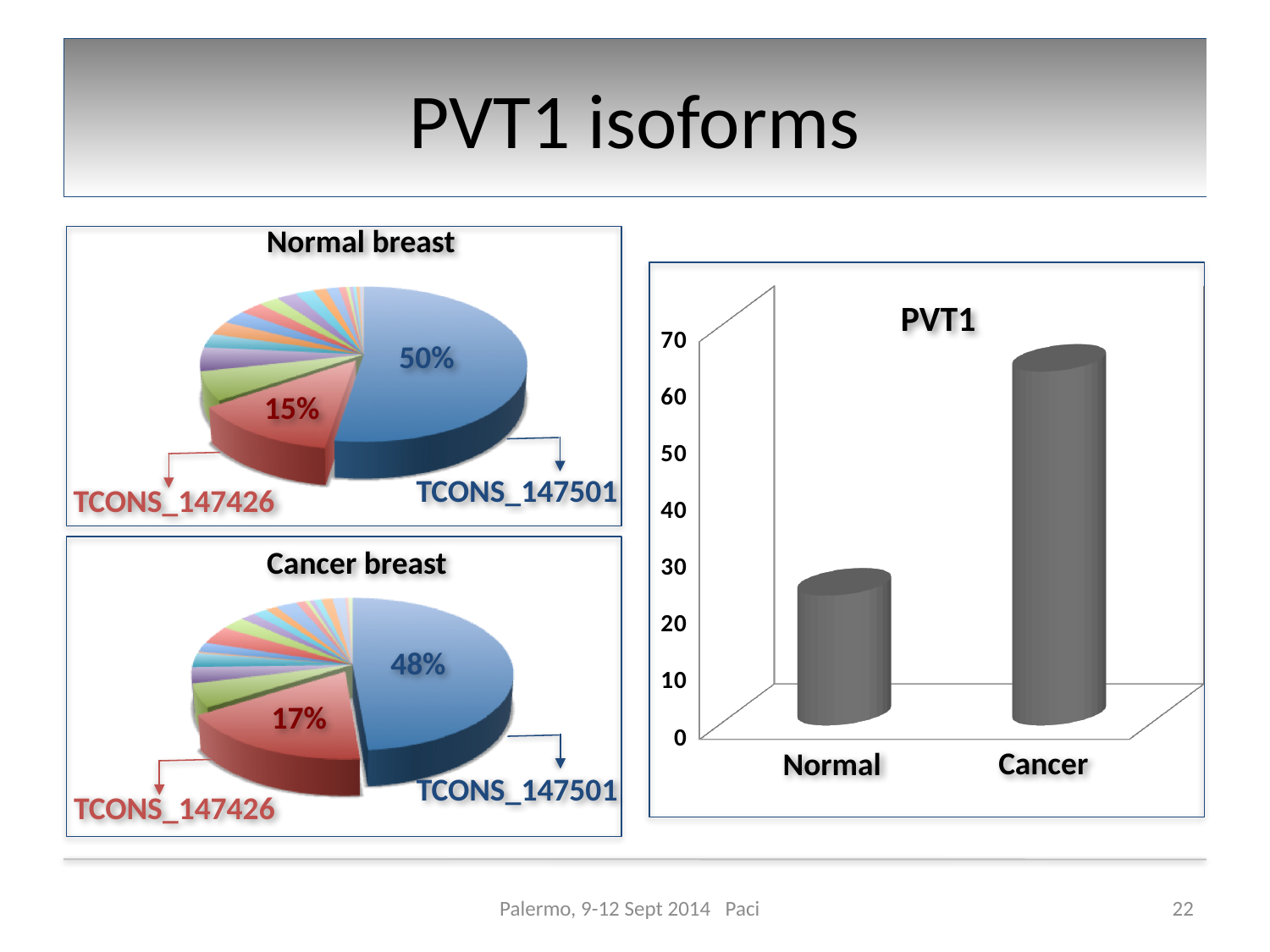
What kind of chart is the Normal breast chart on the left? Pie chart In the PVT1 bar chart, is the value for Cancer greater or less than 50? greater In the Cancer breast pie chart, what share does TCONS_147426 have? 17% How many categories are shown in the PVT1 bar chart? 2 In the Cancer breast pie chart, what is the difference in percentage points between the TCONS_147501 and TCONS_147426 slices? 31 percentage points In the Normal breast pie chart, what is the difference in percentage points between the TCONS_147501 and TCONS_147426 slices? 35 percentage points Comparing the two pie charts, is the TCONS_147426 share larger in Normal breast or in Cancer breast? Cancer breast In the Normal breast pie chart, what share does TCONS_147426 have? 15% In the Normal breast pie chart, what share does TCONS_147501 have? 50% In the PVT1 bar chart, which category has the highest value? Cancer What kind of chart is the PVT1 chart on the right? Bar chart